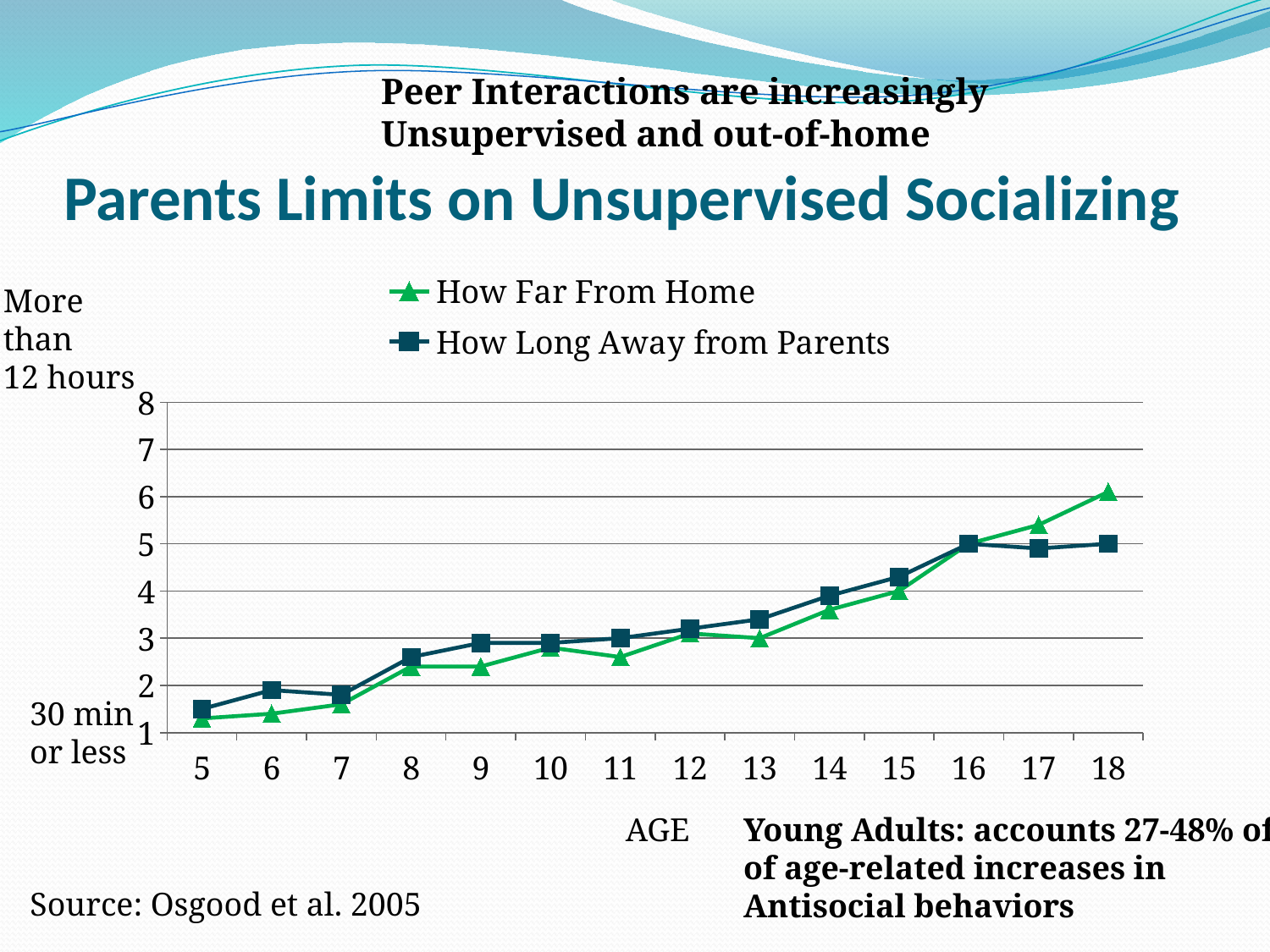
What kind of chart is shown on the slide? Line chart At which age is the value for "How Far From Home" lowest? 5 How many series does the legend list? 2 What is the label on the x axis of the chart? AGE Do the values for "How Far From Home" generally rise or fall as age increases? Rise Is the value for "How Far From Home" at age 17 greater or less than 5? greater At age 18, which series has the higher value, "How Far From Home" or "How Long Away from Parents"? How Far From Home Is the value for "How Far From Home" at age 5 greater or less than 2? less Is the value for "How Long Away from Parents" at age 13 greater or less than 3? greater At age 6, which series has the higher value, "How Far From Home" or "How Long Away from Parents"? How Long Away from Parents How many ages are plotted along the x axis? 14 At which age is the value for "How Far From Home" highest? 18